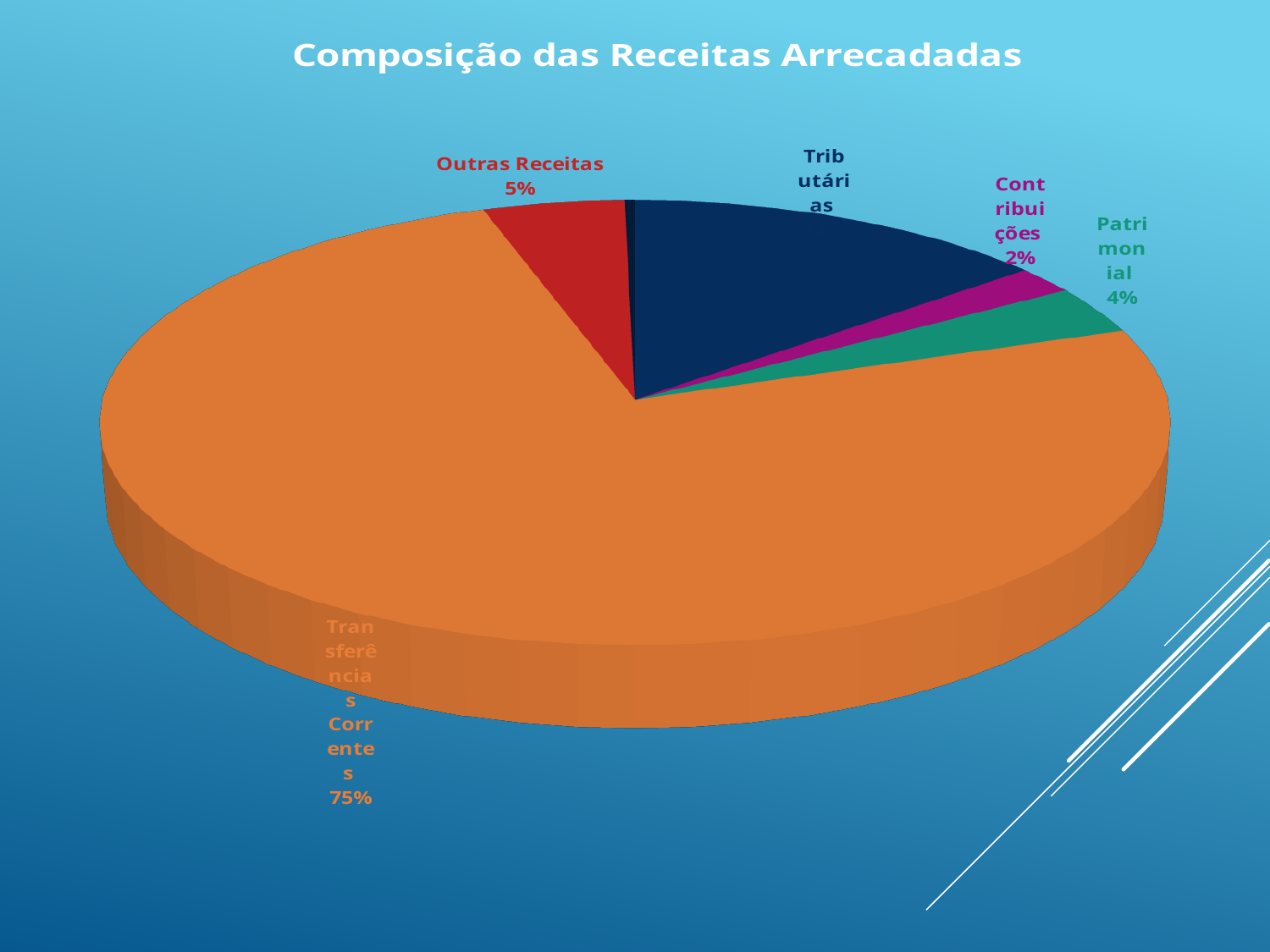
What colour is the Outras Receitas slice? Red What is the difference in percentage points between Transferências Correntes and Outras Receitas? 70 percentage points Which is larger, the share for Patrimonial or the share for Contribuições? Patrimonial What share of the pie is Contribuições? 2% How many slices does the pie chart have? 5 Which category has the largest share of the pie? Transferências Correntes What kind of chart is shown on the slide? Pie chart What share of the pie is Patrimonial? 4% What share of the pie is Transferências Correntes? 75% What is the title of the chart? Composição das Receitas Arrecadadas Which category has the smallest share of the pie? Contribuições